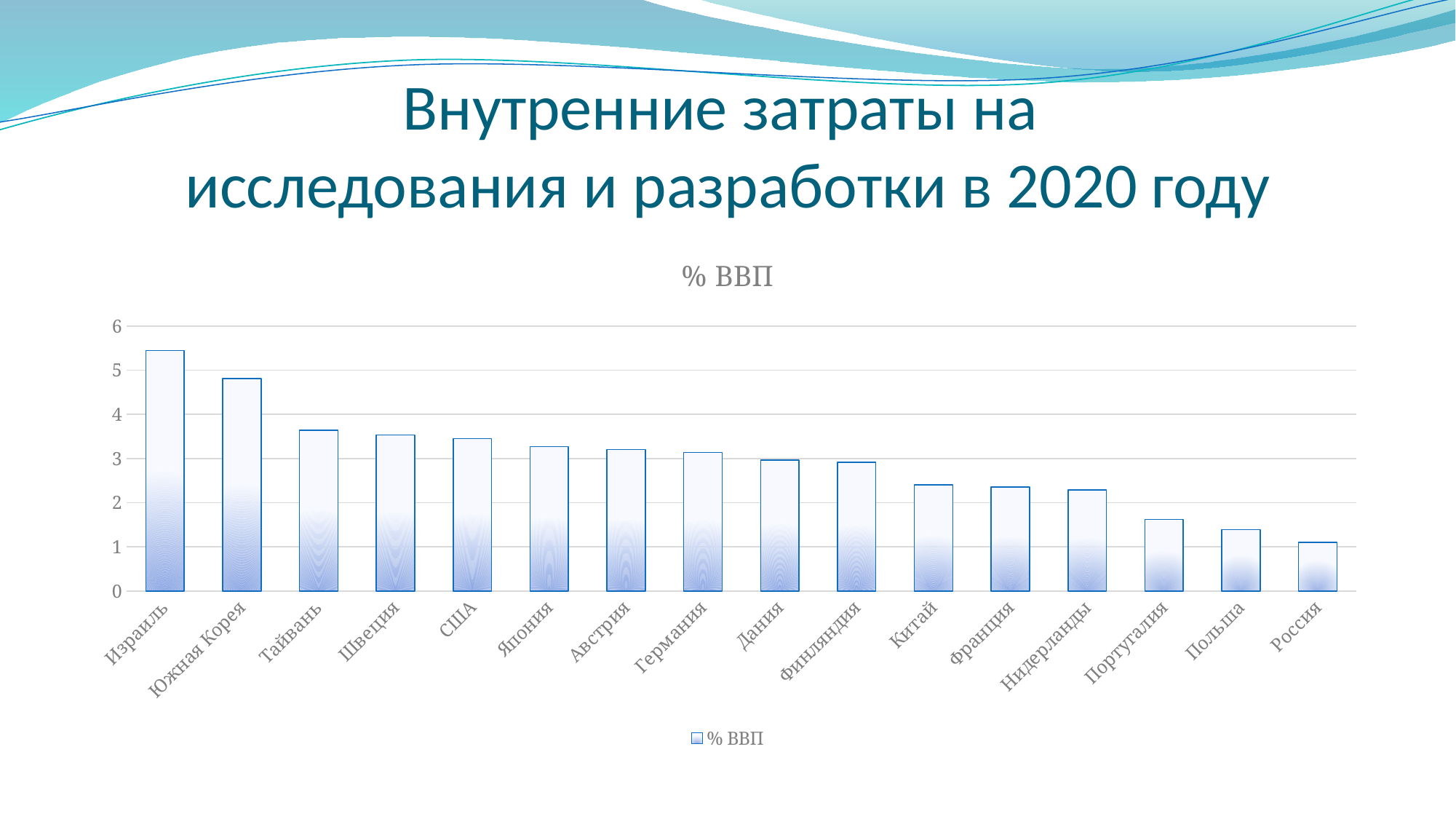
Is the value for Южная Корея greater or less than 5? less Is the value for Израиль greater or less than 5? greater Is the value for Тайвань greater or less than 3? greater Which country has the lowest value in the chart? Россия Which country has the highest value in the chart? Израиль What is the title of the chart? % ВВП What kind of chart is shown on the slide? bar chart How many countries are shown in the chart? 16 Which has the larger value, Израиль or Южная Корея? Израиль How many series does the legend list? 1 Do the values rise or fall from left to right along the x axis? fall